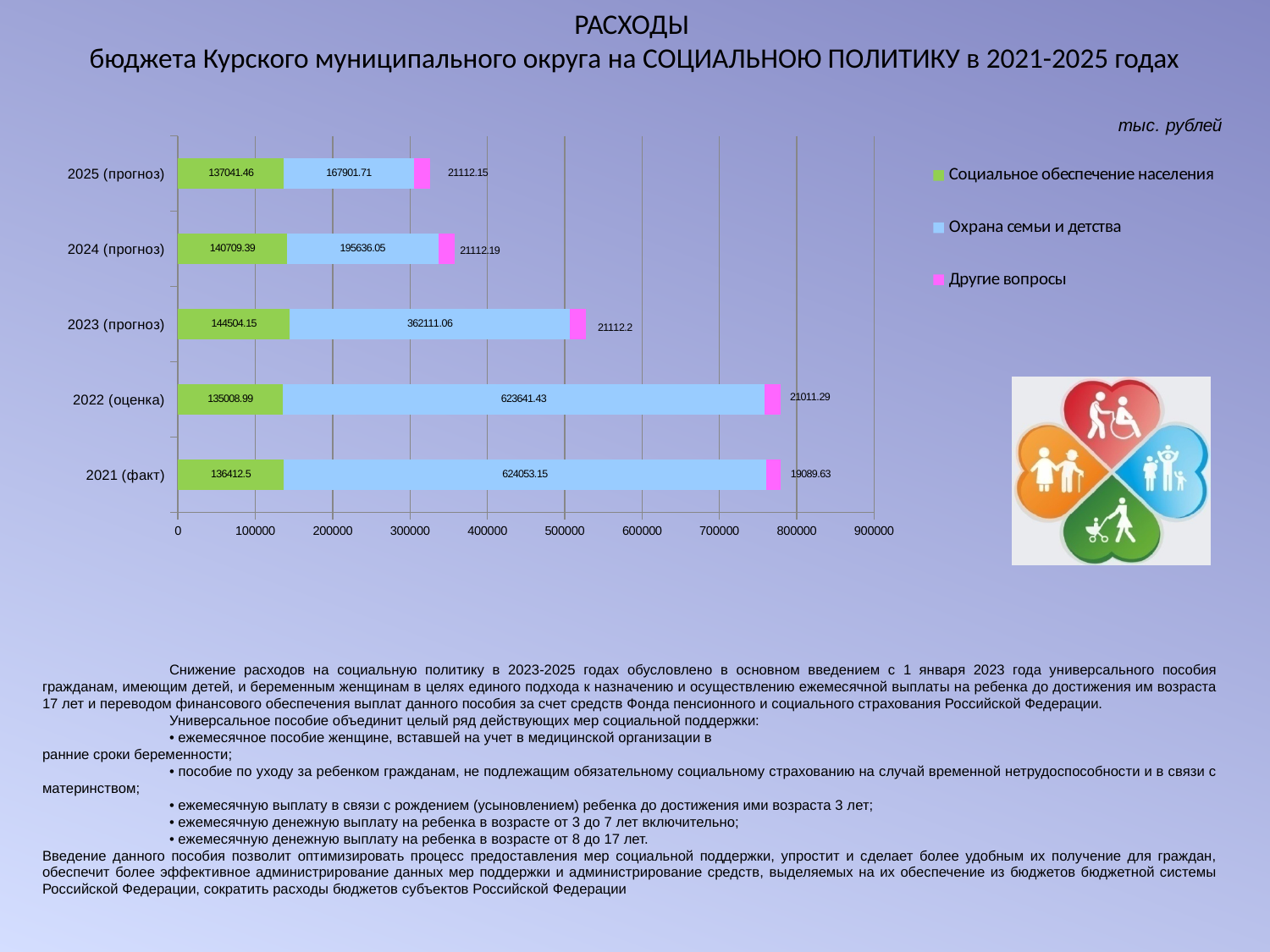
What is the difference between Охрана семьи и детства in 2022 (оценка) and 2023 (прогноз)? 261530.37 How many year categories are plotted on the chart? 5 In which year is the value of Охрана семьи и детства the lowest? 2025 (прогноз) What unit of measurement is indicated above the chart? тыс. рублей What is the value of Социальное обеспечение населения for 2024 (прогноз)? 140709.39 In which year is the value of Социальное обеспечение населения the highest? 2023 (прогноз) What is the value of Другие вопросы for 2022 (оценка)? 21011.29 What is the total of the stacked bar for 2025 (прогноз)? 326055.32 How many series does the legend list? 3 Which is larger: Другие вопросы in 2021 (факт) or in 2022 (оценка)? 2022 (оценка) What type of chart is shown on the slide? Stacked bar chart What is the value of Охрана семьи и детства for 2021 (факт)? 624053.15